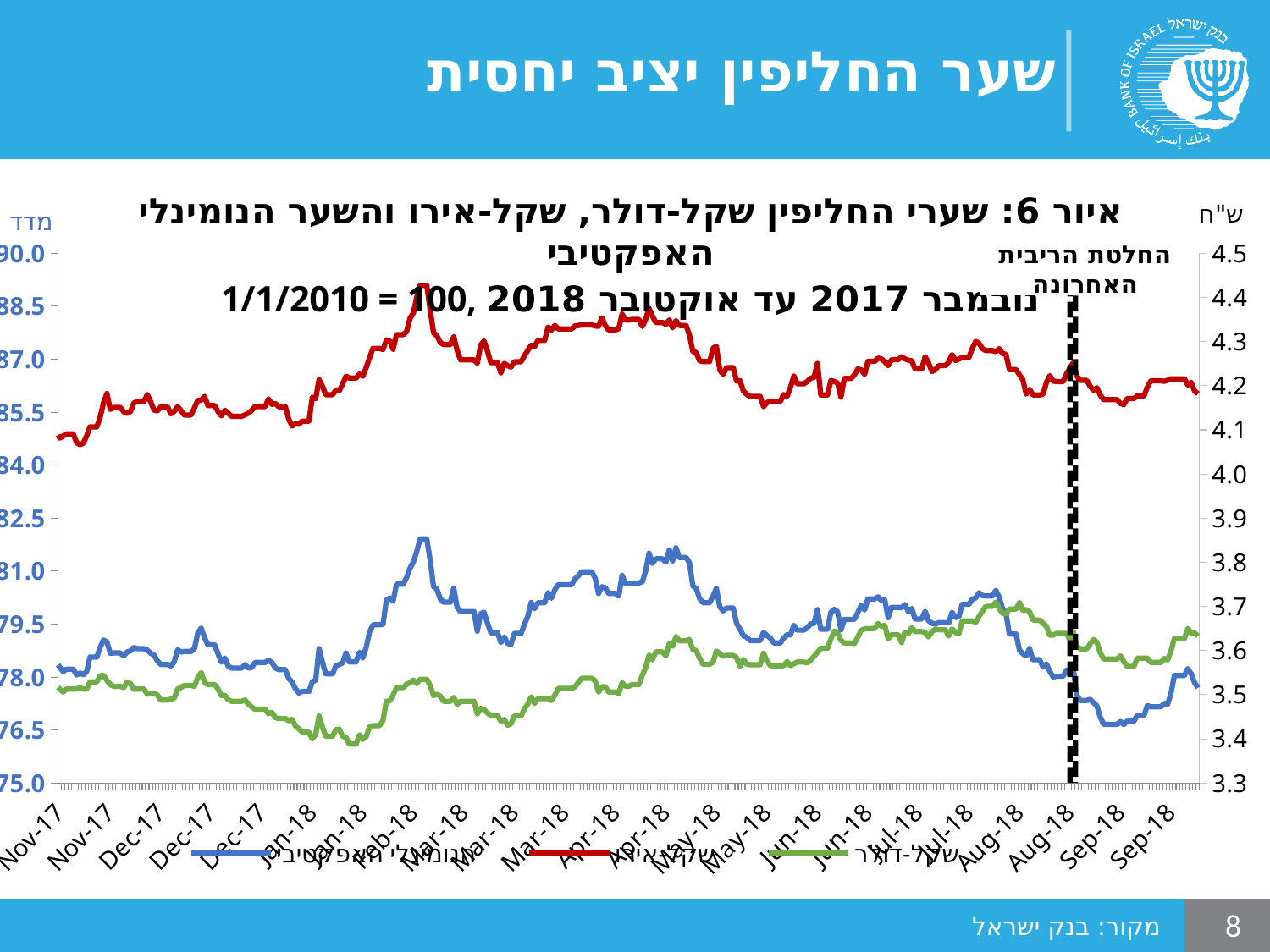
Is the value of the שקל-דולר (green) line at its low point around Jan-18 greater or less than 3.5? less Which line is higher on the right-hand axis throughout the period, שקל-אירו (red) or שקל-דולר (green)? שקל-אירו (red) What is the label of the left vertical axis? מדד Is the value of the שקל-אירו (red) line at its peak around Feb-18 greater or less than 4.3? greater Which series is drawn in red? שקל-אירו What event does the dashed vertical line near Aug-18 mark, according to the annotation? החלטת הריבית האחרונה How many series does the legend list? 3 Is the value of the נומינלי אפקטיבי (blue) line at its low point in Sep-18 greater or less than 78.0? less What kind of chart is shown on the slide? Line chart Does the נומינלי אפקטיבי (blue) line rise or fall between Aug-18 and Sep-18? fall Does the שקל-דולר (green) line rise or fall between Mar-18 and Aug-18? rise